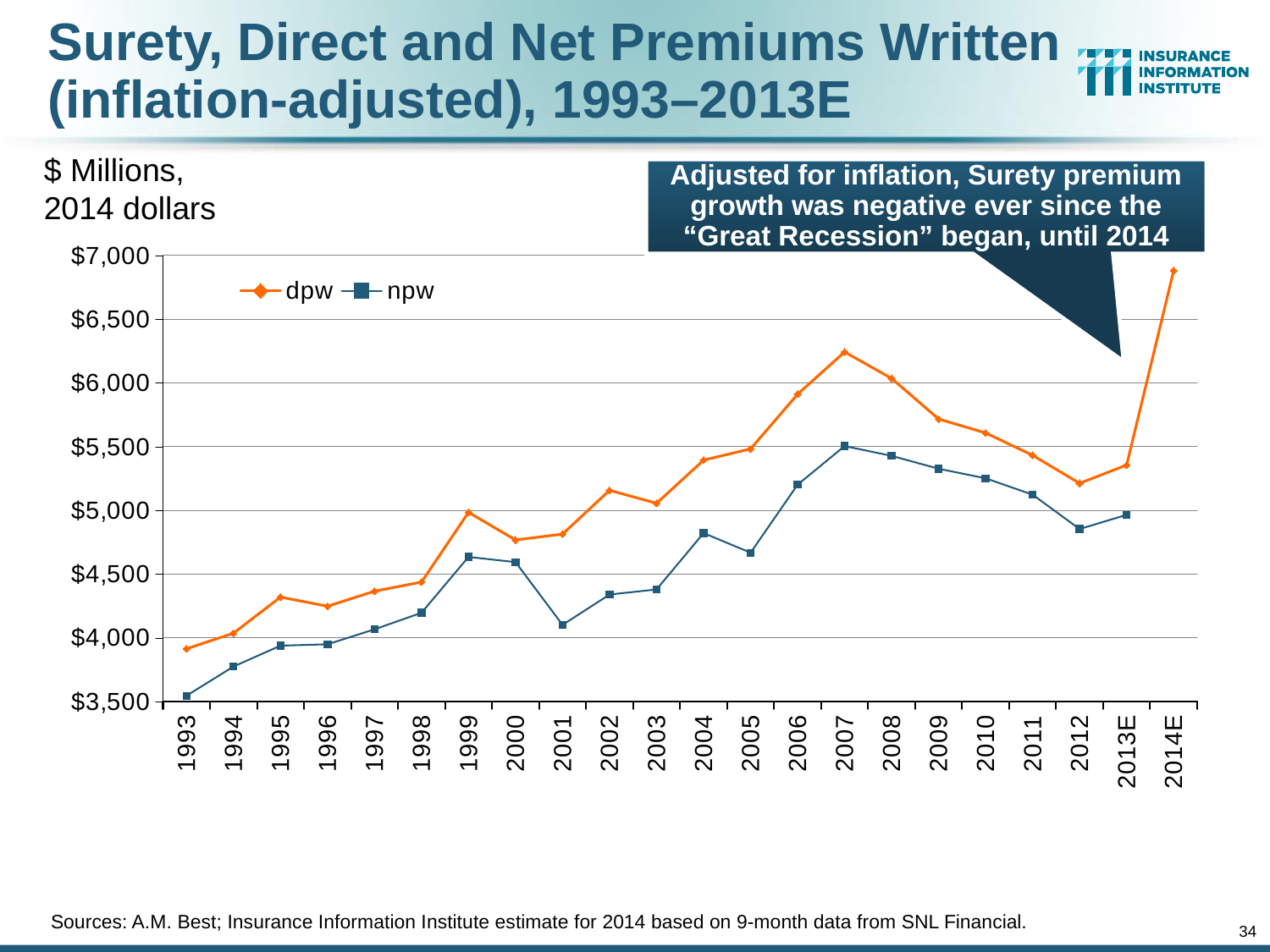
Does the dpw series rise or fall from 2007 to 2012? fall Is the npw value for 2001 greater or less than $4,500? less What kind of chart is shown on the slide? line chart In 2007, which series has the larger value, dpw or npw? dpw In which year is the npw series at its lowest? 1993 Is the dpw value for 2014E greater or less than $6,500? greater How many years are plotted along the x axis? 22 How many series does the legend list? 2 In which year is the dpw series at its lowest? 1993 In which year is the npw series at its highest? 2007 What are the two series named in the legend? dpw and npw In which year is the dpw series at its highest? 2014E